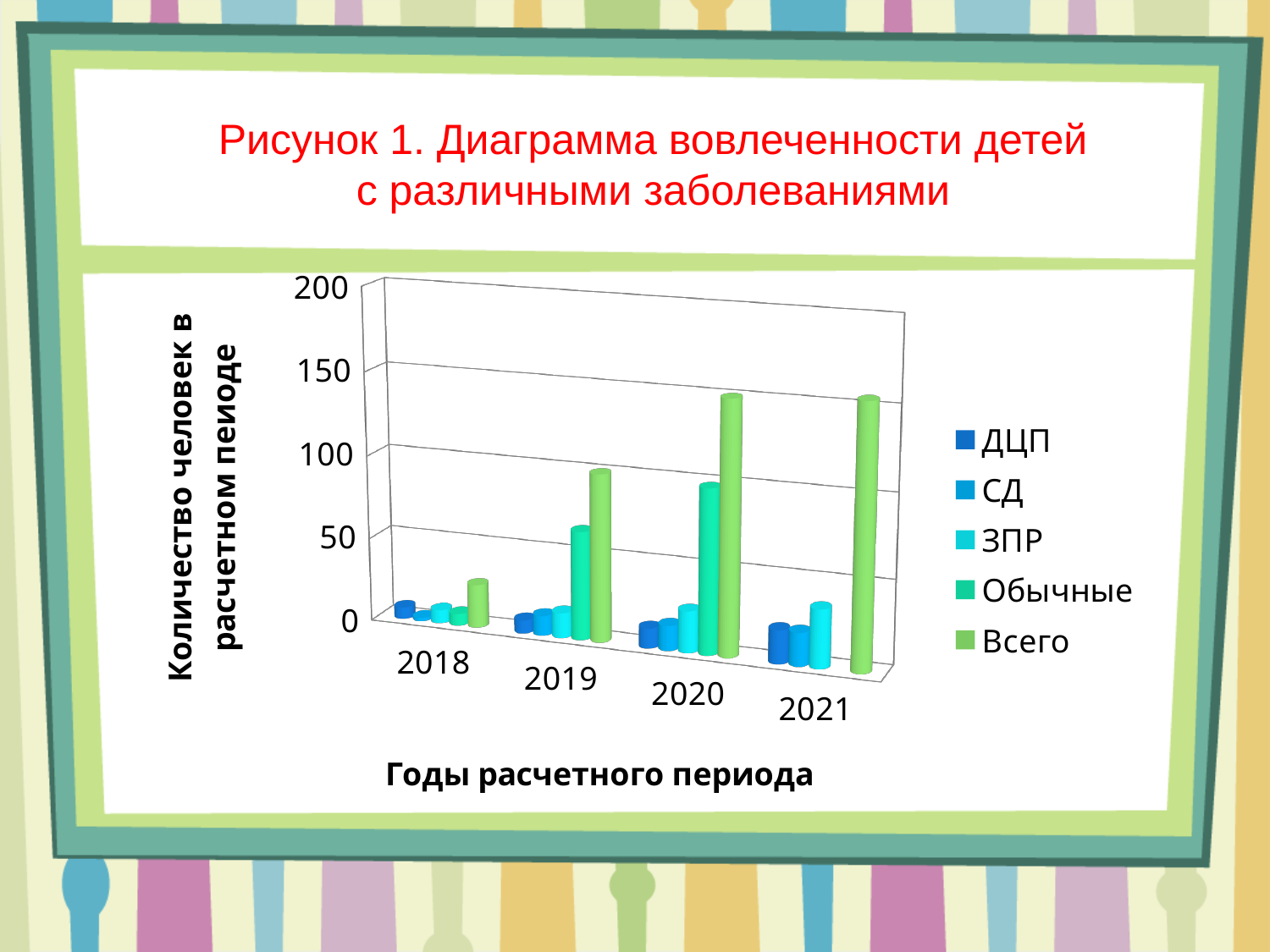
How many years are shown on the x axis? 4 Does the value for Всего rise or fall from 2018 to 2021? rise Is the value for Всего in 2018 greater or less than 50? less In which year is the value for Всего the lowest? 2018 Is the value for Обычные in 2020 greater or less than 50? greater Is the value for Всего in 2020 greater or less than 100? greater What kind of chart is shown on the slide? bar chart How many series does the legend list? 5 Which is larger: the value for Всего in 2019 or in 2020? 2020 Which series has the highest value in 2020? Всего